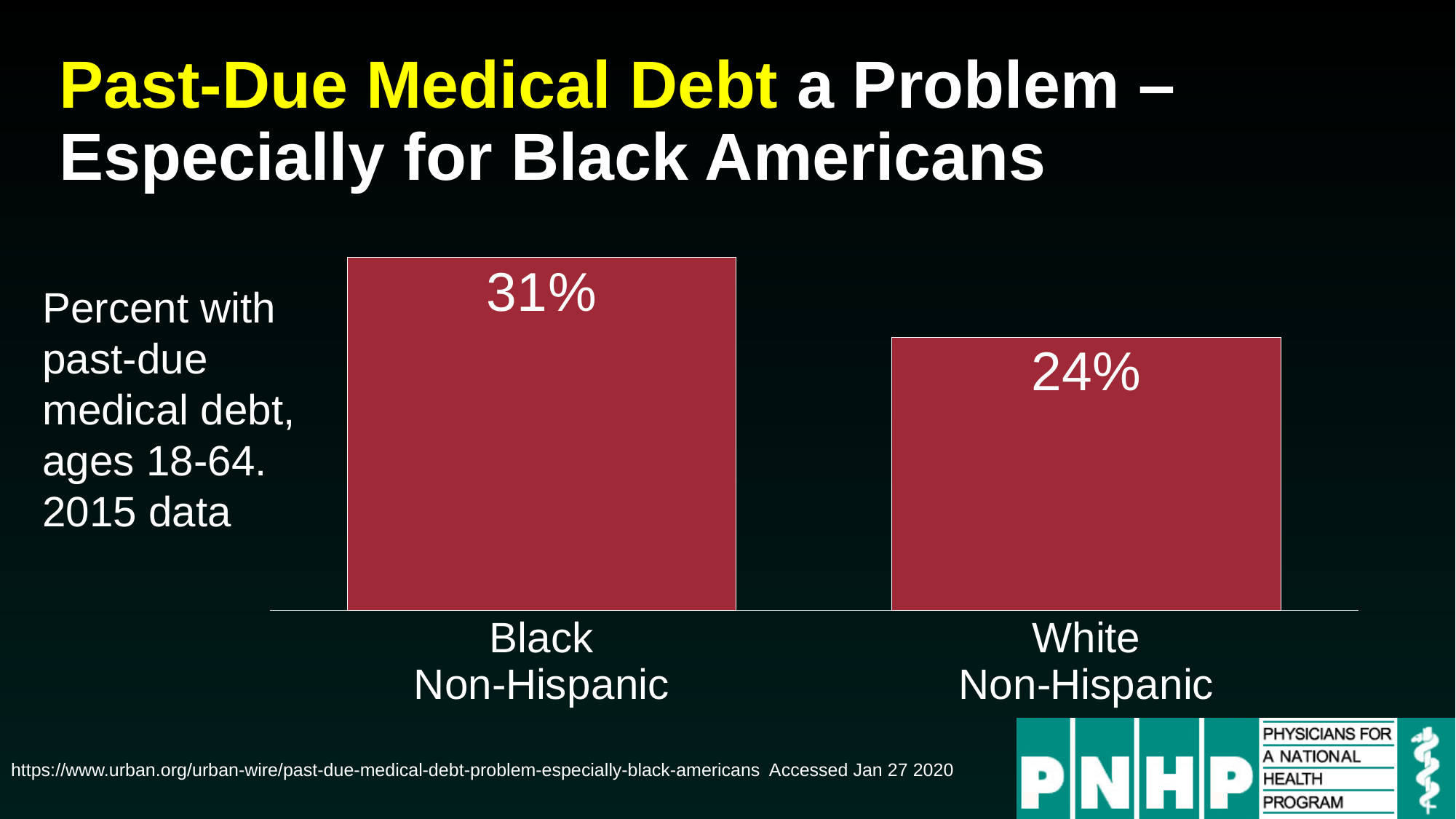
Is the value for Black Non-Hispanic larger or smaller than the value for White Non-Hispanic? larger Which group has the lower percent with past-due medical debt? White Non-Hispanic What is the difference in percentage points between the Black Non-Hispanic and White Non-Hispanic bars? 7 percentage points What percent of White Non-Hispanic adults ages 18-64 had past-due medical debt? 24% What age range does the chart's data cover? 18-64 How many categories are shown on the chart? 2 What kind of chart is shown on the slide? bar chart What percent of Black Non-Hispanic adults ages 18-64 had past-due medical debt? 31% What year is the data on the chart from? 2015 Which group has the higher percent with past-due medical debt? Black Non-Hispanic